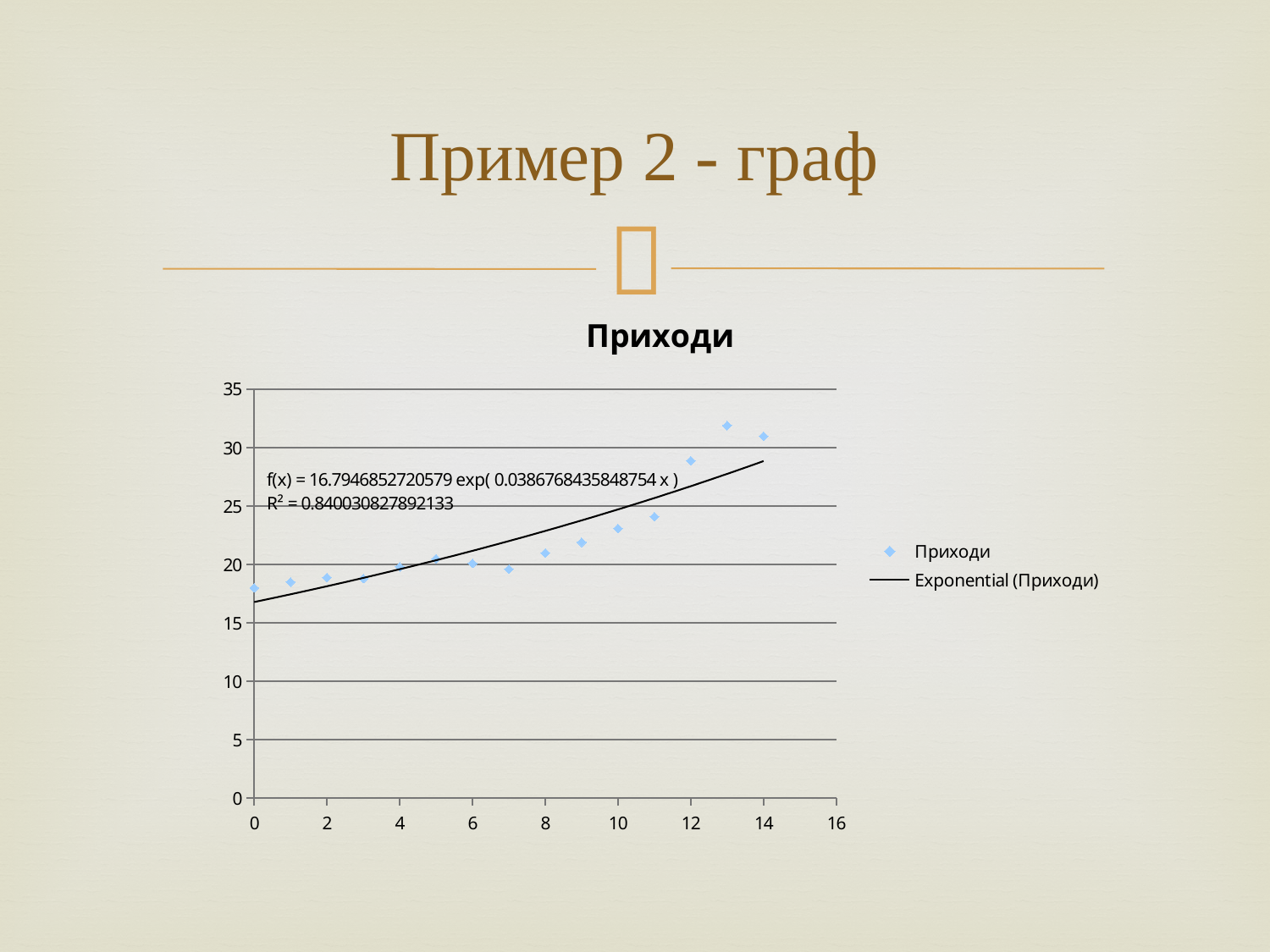
What is the title of the chart? Приходи Is the Приходи value at x = 0 greater or less than 20? less How many data points are plotted for the Приходи series? 15 Is the Приходи value at x = 13 greater or less than 30? greater Do the Приходи values generally rise or fall as x increases from 0 to 14? rise How many entries does the chart legend list? 2 What R² value is shown for the exponential trendline? 0.840030827892133 What kind of chart is shown on the slide? scatter chart At which x value is the Приходи point highest? 13 Which is larger, the Приходи value at x = 12 or at x = 8? x = 12 At which x value is the Приходи point lowest? 0 Is the Приходи value at x = 10 greater or less than 25? less